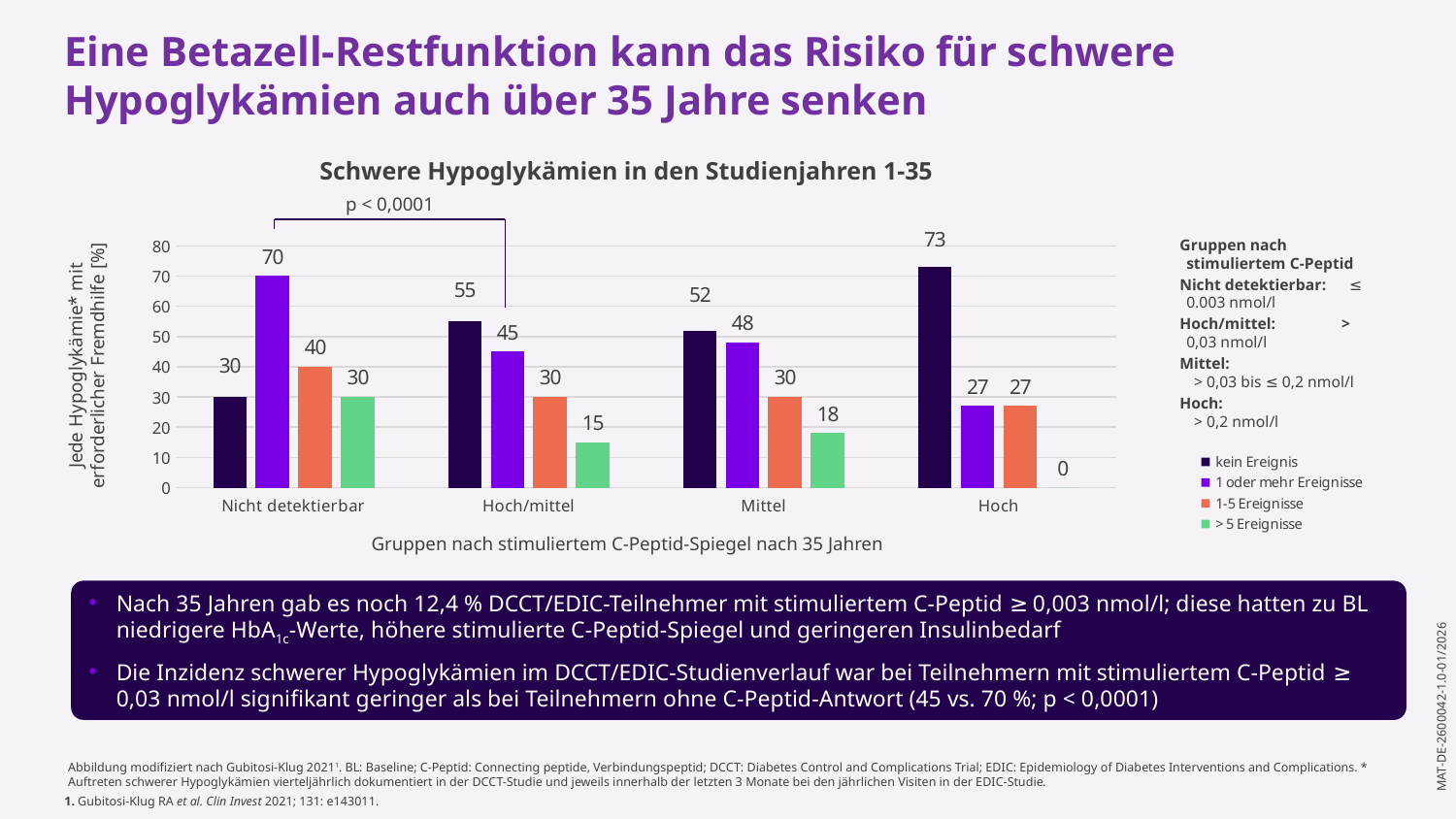
How many series does the legend list? 4 Which is larger: 'kein Ereignis' in the 'Mittel' group or '1 oder mehr Ereignisse' in the 'Mittel' group? kein Ereignis What type of chart is shown on the slide? bar chart What is the value for '1 oder mehr Ereignisse' in the 'Nicht detektierbar' group? 70 Which group has the lowest value for '> 5 Ereignisse'? Hoch What is the value for 'kein Ereignis' in the 'Hoch' group? 73 How many C-peptide groups are shown on the x axis? 4 What is the value for '> 5 Ereignisse' in the 'Hoch/mittel' group? 15 What is the value for '1-5 Ereignisse' in the 'Mittel' group? 30 What is the title of the chart? Schwere Hypoglykämien in den Studienjahren 1-35 Which group has the highest value for 'kein Ereignis'? Hoch What is the difference between the '1 oder mehr Ereignisse' values for 'Nicht detektierbar' and 'Hoch/mittel'? 25